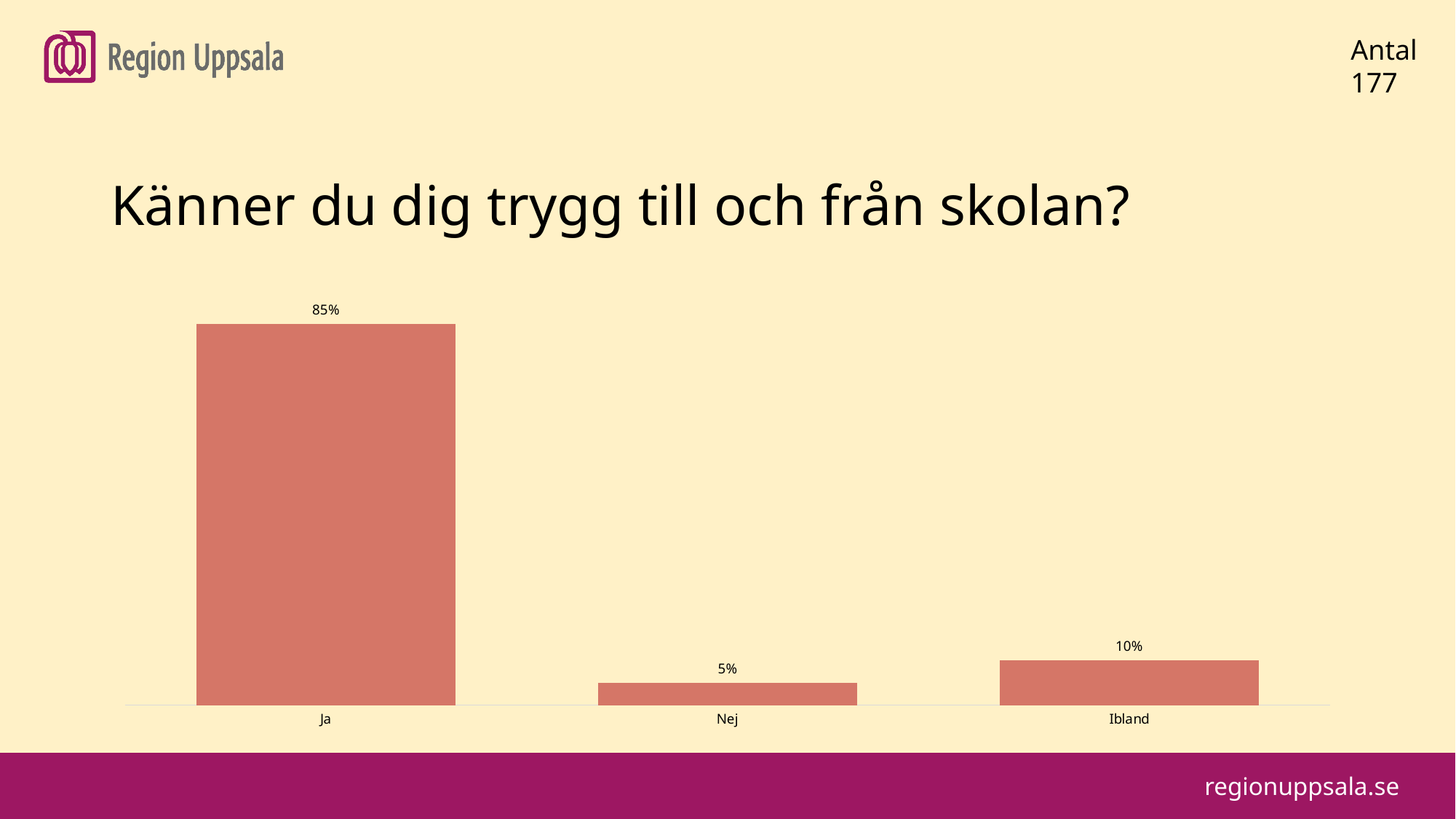
Which category has the lowest value? Nej What is the value for Nej? 5% What is the value for Ibland? 10% What is the value for Ja? 85% What is the total of the three values shown in the chart? 100% What kind of chart is shown on the slide? Bar chart What is the difference between the values for Ibland and Nej? 5% What question does the slide title ask? Känner du dig trygg till och från skolan? Which category has the highest value? Ja Which is larger, the value for Nej or the value for Ibland? Ibland How many categories are shown on the x axis? 3 What is the difference between the values for Ja and Ibland? 75%